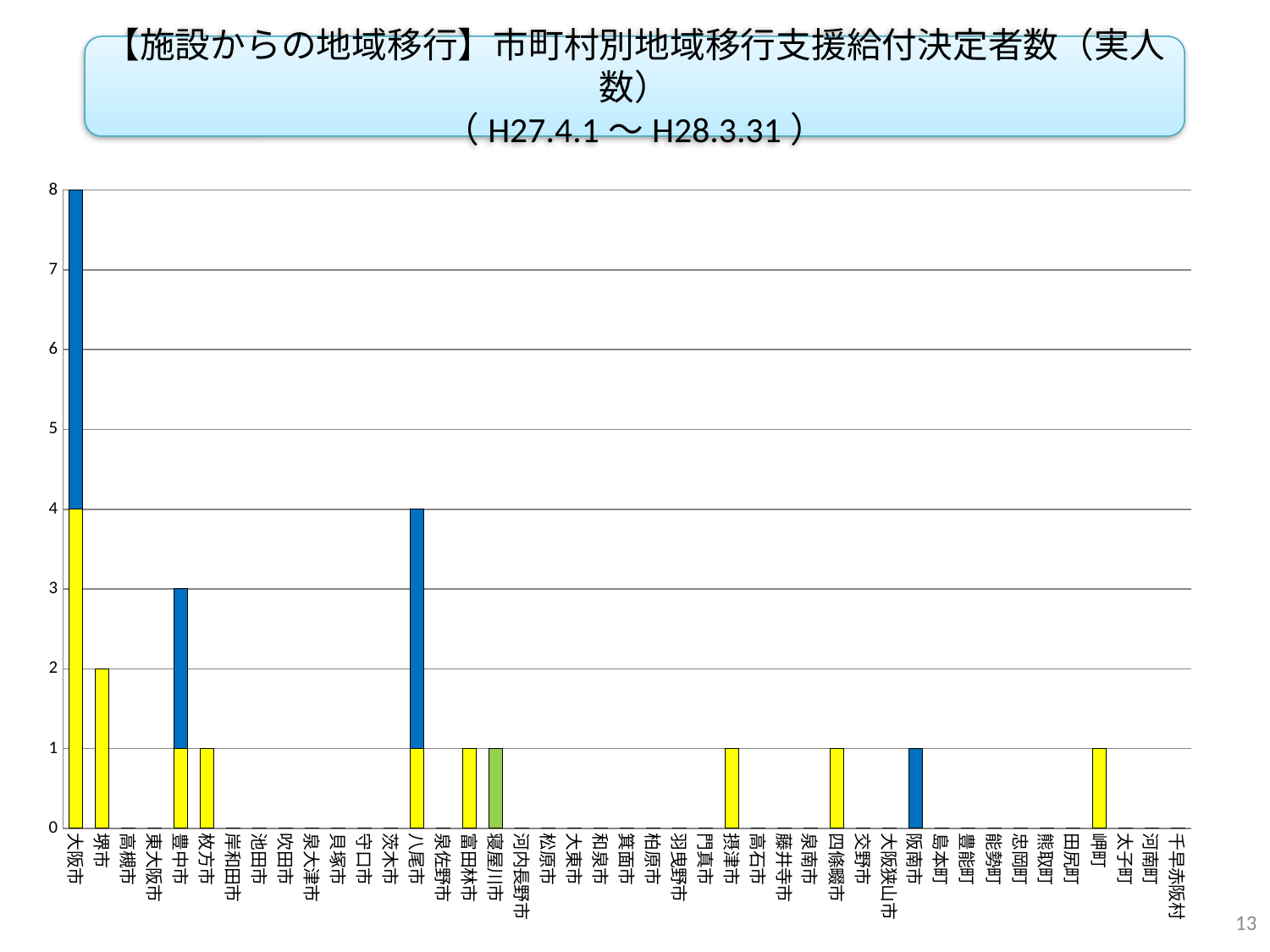
How many municipalities are listed on the x axis? 43 Which municipality has the highest bar? 大阪市 What is the total value of the bar for 大阪市? 8 What kind of chart is shown on the slide? Stacked bar chart Which municipality is the only one with a green bar? 寝屋川市 What is the value of the yellow segment of the bar for 大阪市? 4 Which has a larger total, 豊中市 or 堺市? 豊中市 What is the total value of the bar for 豊中市? 3 What is the value for 堺市? 2 How many municipalities have a bar with a value greater than 0? 11 What is the total value of the bar for 八尾市? 4 What is the difference between the total for 大阪市 and the total for 八尾市? 4